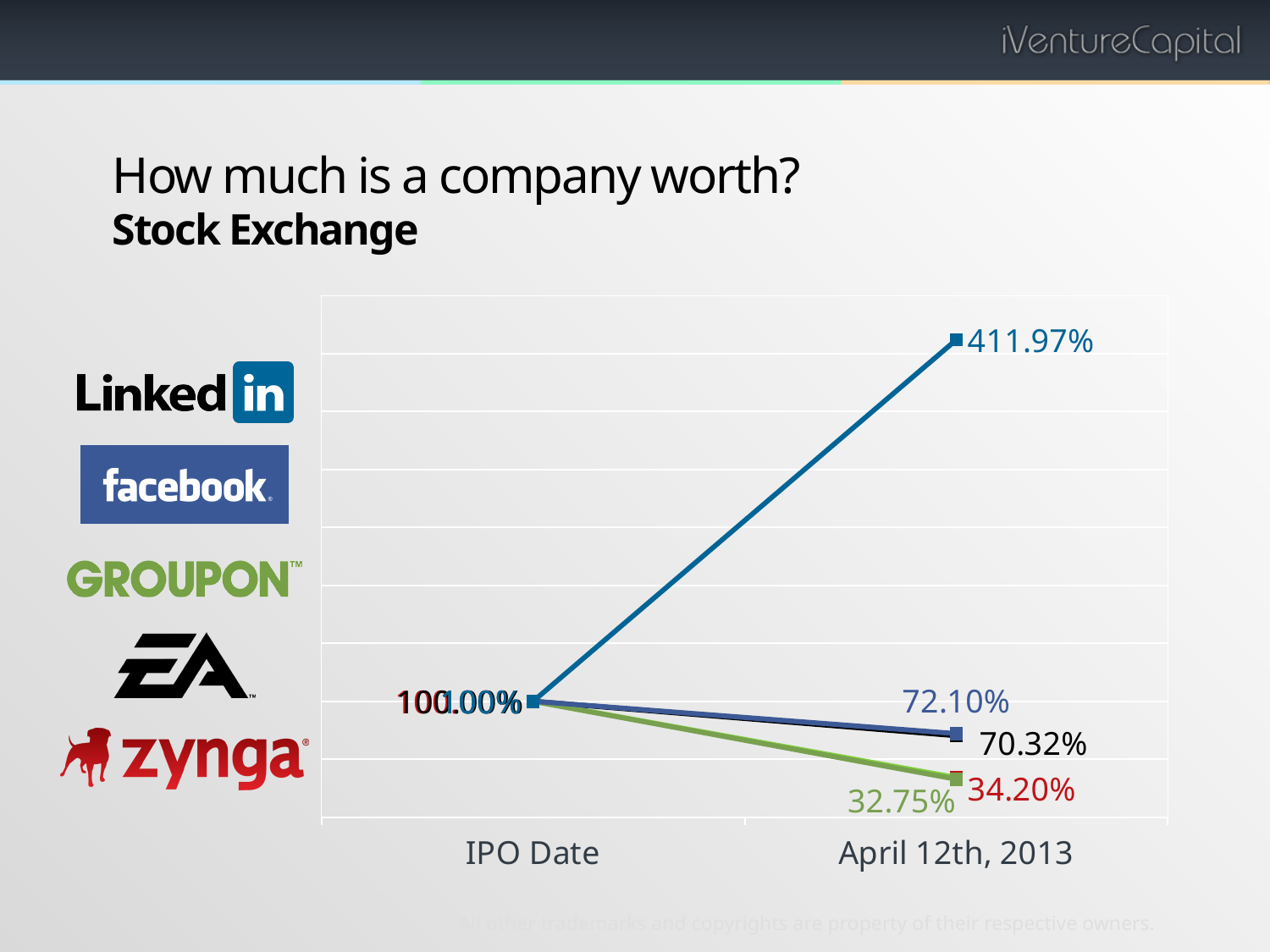
Does the top line rise or fall from the IPO Date to April 12th, 2013? rise What is the value of the green line (Groupon) at April 12th, 2013? 32.75% What value do all the lines share at the IPO Date? 100.00% What kind of chart is shown on the slide? line chart What is the highest value shown at April 12th, 2013? 411.97% What is the value labelled in red (Zynga) at April 12th, 2013? 34.20% How many categories are on the x axis of the chart? 2 Which is larger at April 12th, 2013: the value 72.10% or the value 34.20%? 72.10% What is the value labelled in black (EA) at April 12th, 2013? 70.32% How many companies are represented by the logos next to the chart? 5 By how many percentage points does the top line rise from the IPO Date (100.00%) to April 12th, 2013 (411.97%)? 311.97 percentage points What is the lowest value shown at April 12th, 2013? 32.75%